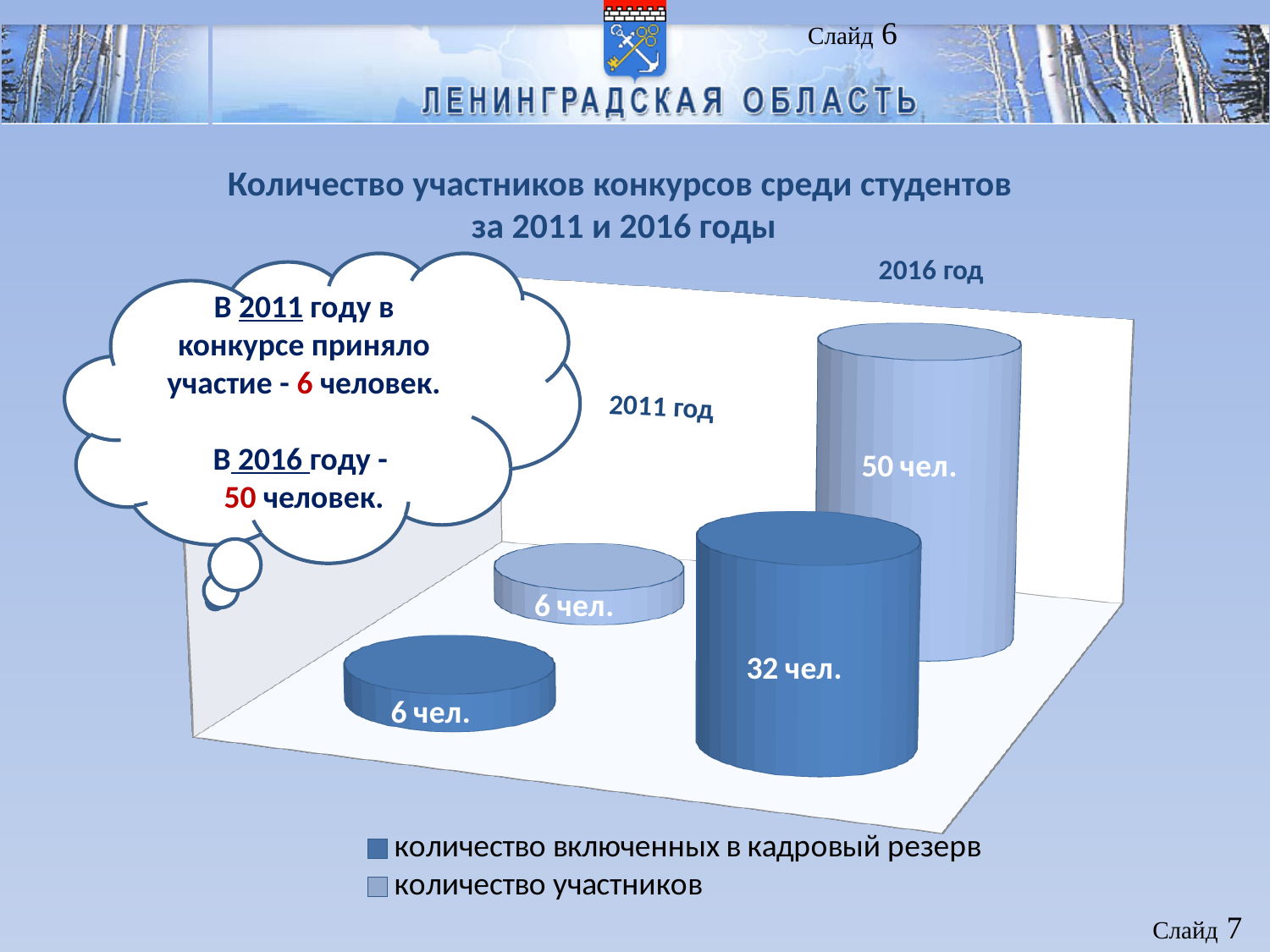
What is the title of the chart on the slide? Количество участников конкурсов среди студентов за 2011 и 2016 годы How many year categories are shown in the chart? 2 What kind of chart is shown on the slide? bar chart What is the value of 'количество участников' for 2016 год? 50 чел. What is the value of 'количество включенных в кадровый резерв' for 2016 год? 32 чел. By how much did 'количество участников' increase from 2011 год to 2016 год? 44 чел. Does 'количество включенных в кадровый резерв' rise or fall from 2011 год to 2016 год? rise What is the value of 'количество участников' for 2011 год? 6 чел. Which year has the highest value for 'количество участников'? 2016 год What is the difference between 'количество участников' and 'количество включенных в кадровый резерв' in 2016 год? 18 чел. How many series does the chart legend list? 2 What is the value of 'количество включенных в кадровый резерв' for 2011 год? 6 чел.